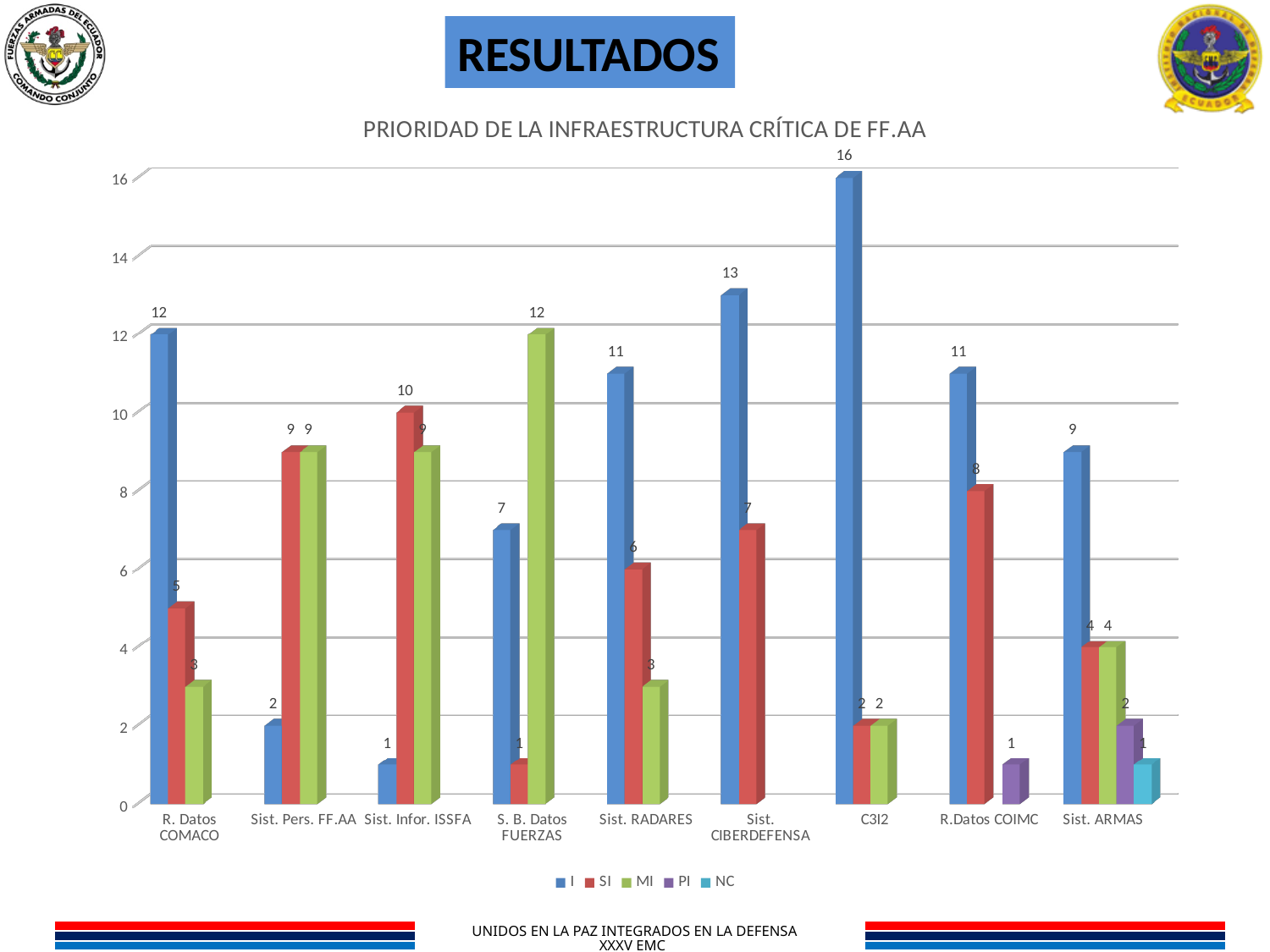
How many categories are shown on the x axis? 9 How many series does the legend list? 5 What is the difference between the I value and the SI value for R. Datos COMACO? 7 What is the total of all series values for Sist. ARMAS? 20 Which category has the highest value in the I series? C3I2 What is the NC value for Sist. ARMAS? 1 What is the MI value for S. B. Datos FUERZAS? 12 Which category has the lowest value in the I series? Sist. Infor. ISSFA What kind of chart is shown on the slide? Bar chart What is the value of the I series for C3I2? 16 Which has a larger SI value, Sist. Infor. ISSFA or Sist. Pers. FF.AA? Sist. Infor. ISSFA What is the title of the chart? PRIORIDAD DE LA INFRAESTRUCTURA CRÍTICA DE FF.AA